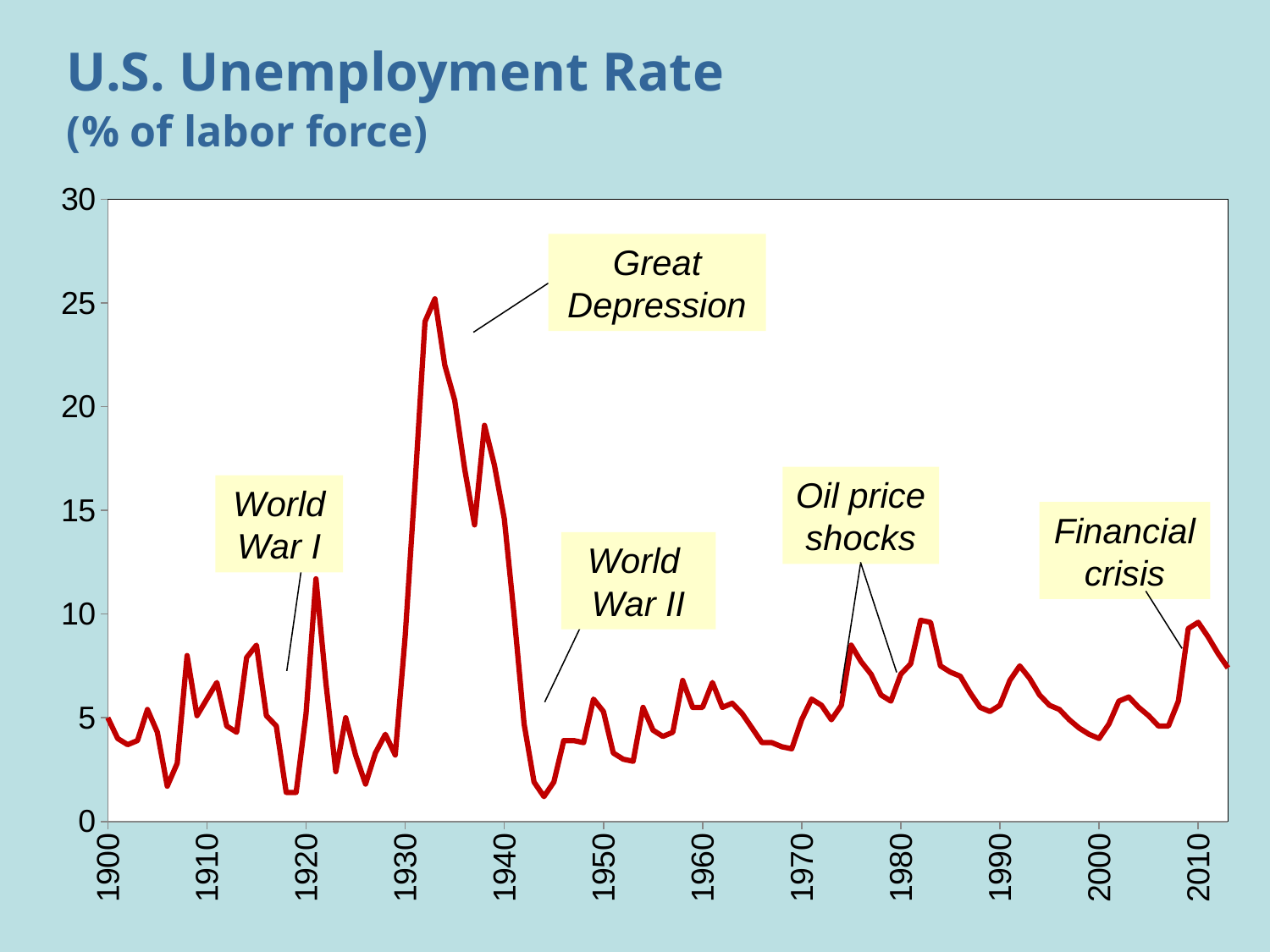
Is the unemployment rate around 1944, during World War II, greater or less than 5? less Is the unemployment rate around 1921, at the World War I spike, greater or less than 10? greater Is the peak unemployment rate during the Great Depression greater or less than 20? greater Does the unemployment rate rise or fall between 1933 and 1944? fall What is the title of the chart? U.S. Unemployment Rate (% of labor force) Which annotated event corresponds to the highest peak in the unemployment rate? Great Depression What kind of chart is shown on the slide? Line chart Which is higher, the peak unemployment rate during the Great Depression or the peak during the Financial crisis? Great Depression Does the unemployment rate rise or fall between 2007 and 2010? rise How many data series are plotted on the chart? 1